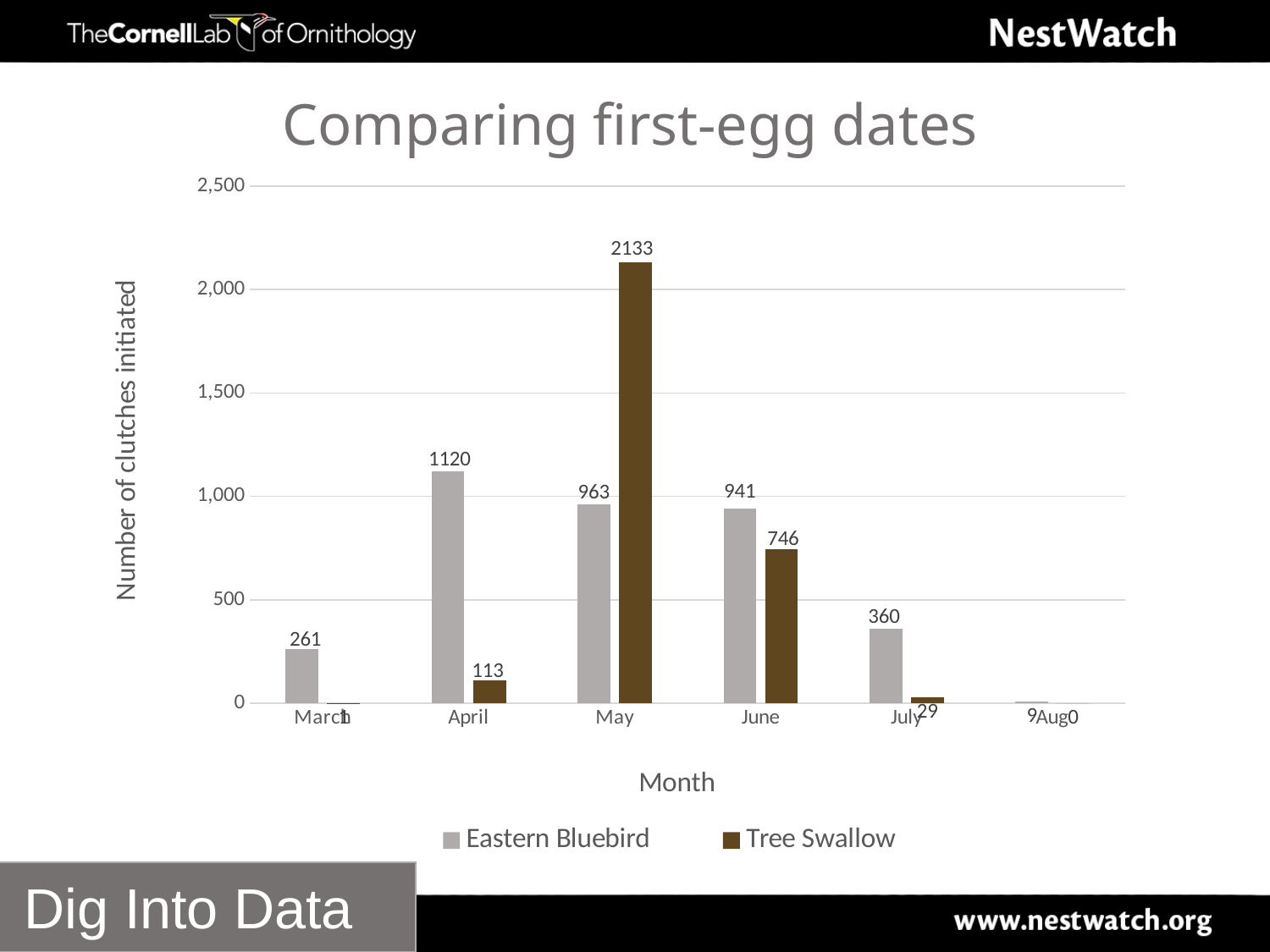
In which month does Eastern Bluebird have the highest number of clutches initiated? April How many months are shown on the x axis? 6 What is the value for Tree Swallow in April? 113 What is the title of the y axis? Number of clutches initiated In June, which species has the larger number of clutches initiated? Eastern Bluebird What is the number of clutches initiated by Tree Swallow in May? 2133 How many series does the legend list? 2 In which month does Tree Swallow have the highest number of clutches initiated? May What is the number of clutches initiated by Eastern Bluebird in April? 1120 Is the value for Eastern Bluebird in July greater or less than 500? less What is the value for Tree Swallow in June? 746 In May, how much larger is the Tree Swallow value than the Eastern Bluebird value? 1170